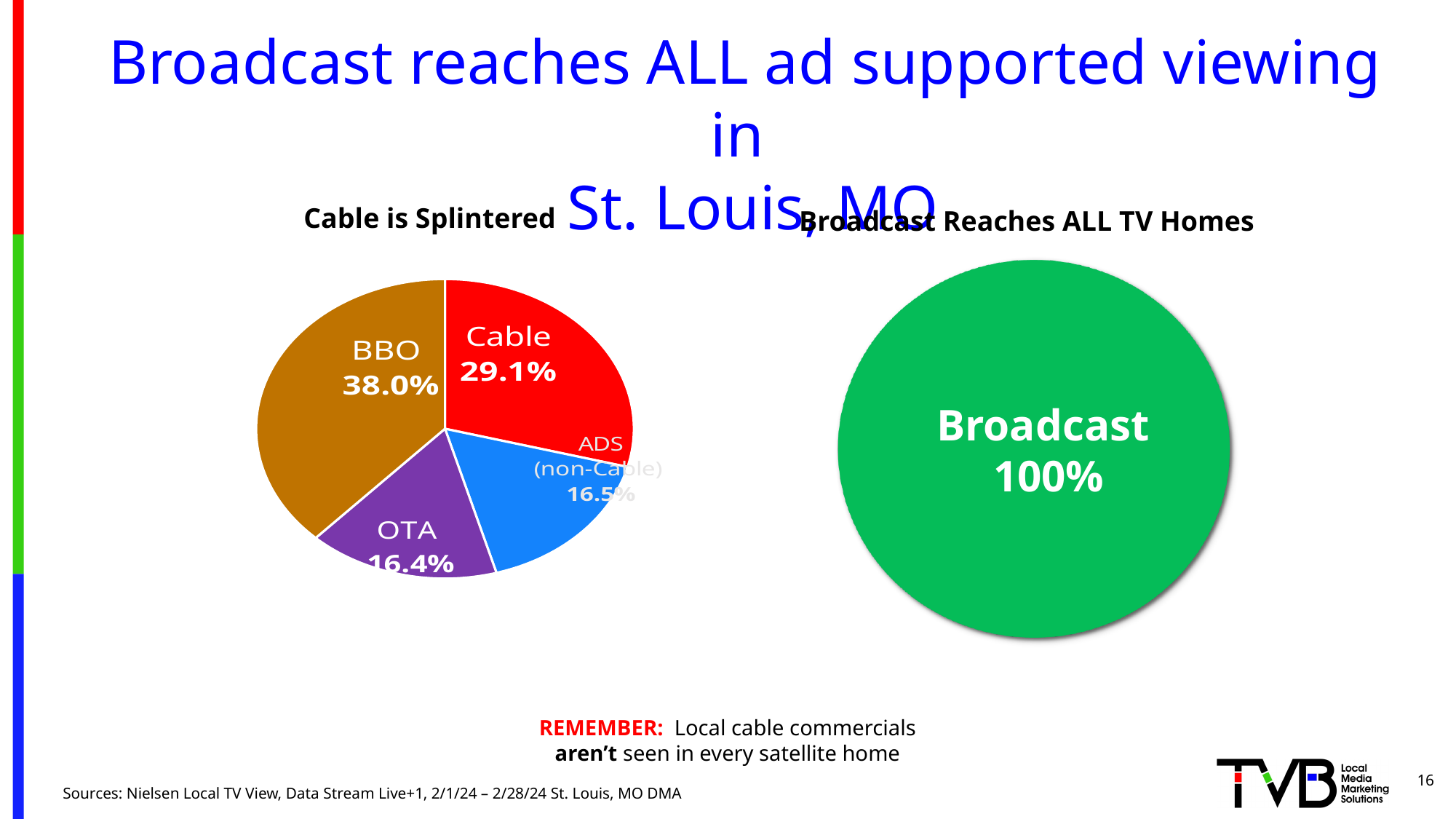
In the "Cable is Splintered" pie chart, what is the value for OTA? 16.4% In the "Cable is Splintered" pie chart, what is the difference between the BBO and Cable shares? 8.9% In the "Cable is Splintered" pie chart, how many slices are there? 4 In the "Cable is Splintered" pie chart, what colour is the BBO slice? Brown In the "Cable is Splintered" pie chart, what is the value for ADS (non-Cable)? 16.5% In the "Cable is Splintered" pie chart, which slice is the smallest? OTA In the "Broadcast Reaches ALL TV Homes" chart, what percentage is shown for Broadcast? 100% In the "Cable is Splintered" pie chart, which slice is the largest? BBO In the "Cable is Splintered" pie chart, what share does Cable have? 29.1% In the "Cable is Splintered" pie chart, what is the value for BBO? 38.0% In the "Cable is Splintered" pie chart, which is larger, Cable or OTA? Cable What kind of chart is the "Cable is Splintered" chart? Pie chart